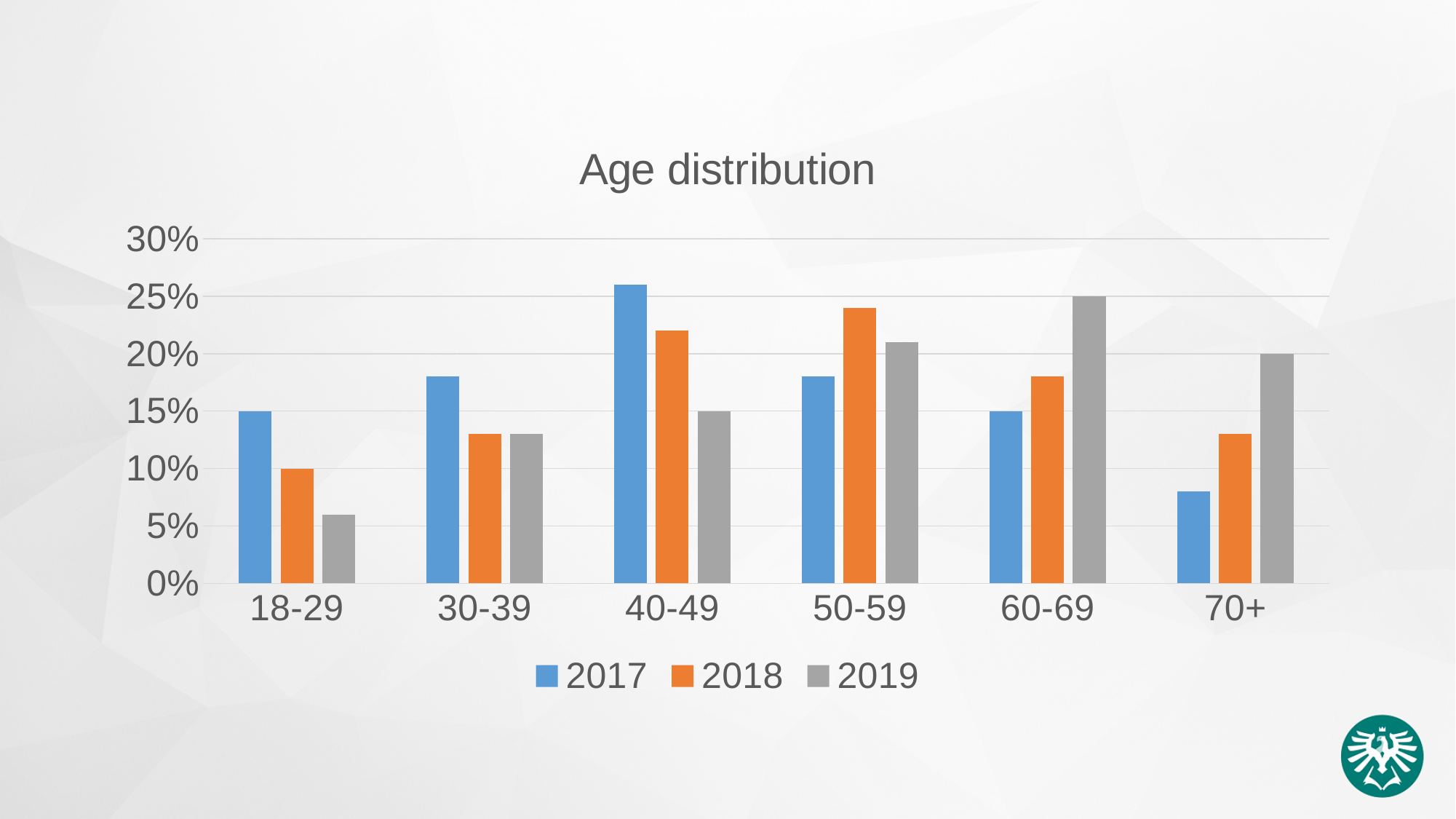
Is the value for the 50-59 group in 2018 greater or less than 20%? greater How many age categories are shown on the x axis? 6 Which age group has the highest value for 2017? 40-49 What is the value for the 18-29 group in 2017? 15% What is the value for the 18-29 group in 2018? 10% How many series does the legend list? 3 Which age group has the lowest value for 2019? 18-29 What type of chart is shown on the slide? bar chart What is the value for the 70+ group in 2019? 20% What is the value for the 60-69 group in 2019? 25% What is the title of the chart? Age distribution Which is larger for the 70+ group, the 2017 value or the 2019 value? 2019